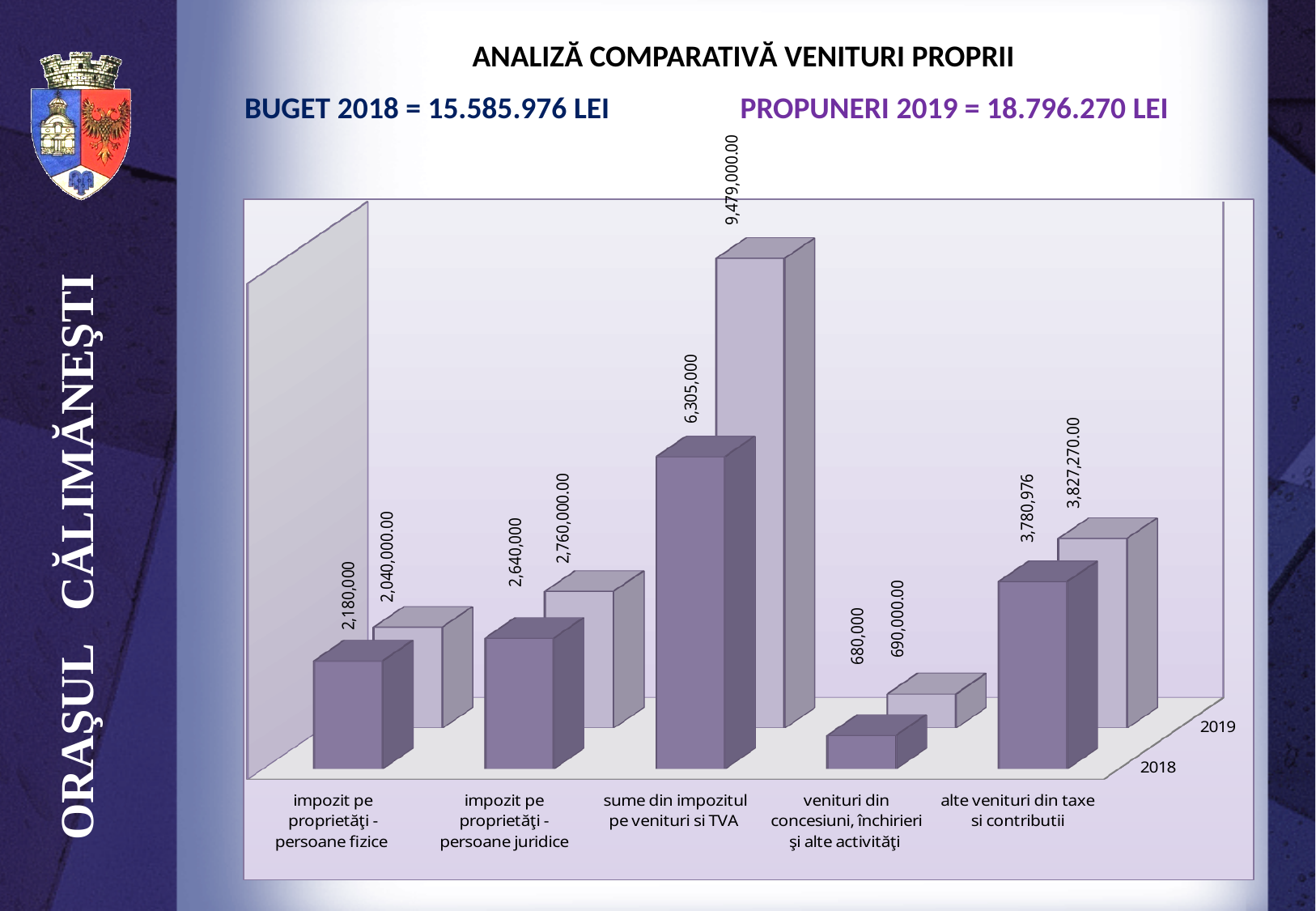
Which category has the lowest 2018 value? venituri din concesiuni, închirieri şi alte activităţi Which category has the highest 2019 value? sume din impozitul pe venituri si TVA What kind of chart is shown on the slide? bar chart What is the 2018 value for 'sume din impozitul pe venituri si TVA'? 6,305,000 What is the 2018 value for 'venituri din concesiuni, închirieri şi alte activităţi'? 680,000 What is the 2019 value for 'sume din impozitul pe venituri si TVA'? 9,479,000.00 How many data series (years) does the chart show? 2 What is the difference between the 2019 and 2018 values for 'sume din impozitul pe venituri si TVA'? 3,174,000 For 'impozit pe proprietăți - persoane fizice', which year has the larger value, 2018 or 2019? 2018 How many categories are shown on the x axis of the chart? 5 What is the 2018 value for 'impozit pe proprietăți - persoane fizice'? 2,180,000 What is the 2019 value for 'alte venituri din taxe si contributii'? 3,827,270.00